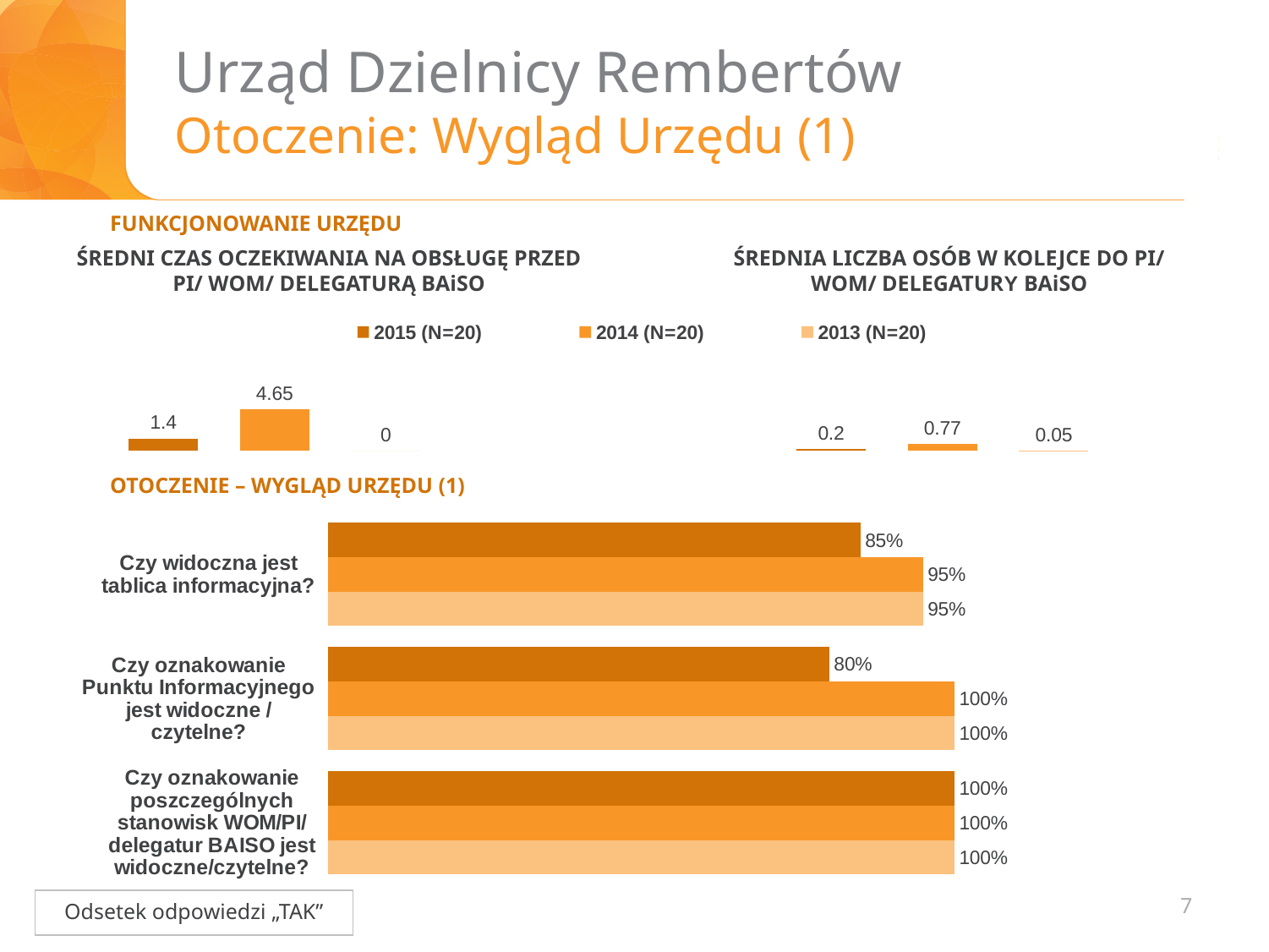
In the chart 'ŚREDNIA LICZBA OSÓB W KOLEJCE DO PI/ WOM/ DELEGATURY BAiSO', what is the value for 2015 (N=20)? 0.2 In the chart 'ŚREDNIA LICZBA OSÓB W KOLEJCE DO PI/ WOM/ DELEGATURY BAiSO', which year has the lowest value? 2013 (N=20) How many question categories are shown in the bottom chart 'OTOCZENIE – WYGLĄD URZĘDU (1)'? 3 In the bottom chart 'OTOCZENIE – WYGLĄD URZĘDU (1)', what is the difference between the 2014 and 2015 values for 'Czy oznakowanie Punktu Informacyjnego jest widoczne / czytelne?'? 20% In the chart 'ŚREDNI CZAS OCZEKIWANIA NA OBSŁUGĘ PRZED PI/ WOM/ DELEGATURĄ BAiSO', what is the difference between the 2014 and 2015 values? 3.25 In the chart 'ŚREDNIA LICZBA OSÓB W KOLEJCE DO PI/ WOM/ DELEGATURY BAiSO', which is larger: the value for 2014 or the value for 2015? 2014 In the chart 'ŚREDNI CZAS OCZEKIWANIA NA OBSŁUGĘ PRZED PI/ WOM/ DELEGATURĄ BAiSO', which year has the highest value? 2014 (N=20) How many series does the legend above the top charts list? 3 In the bottom chart 'OTOCZENIE – WYGLĄD URZĘDU (1)', what is the 2014 value for 'Czy oznakowanie Punktu Informacyjnego jest widoczne / czytelne?'? 100% In the bottom chart 'OTOCZENIE – WYGLĄD URZĘDU (1)', what is the 2015 value for 'Czy widoczna jest tablica informacyjna?'? 85% In the chart 'ŚREDNI CZAS OCZEKIWANIA NA OBSŁUGĘ PRZED PI/ WOM/ DELEGATURĄ BAiSO', what is the value for 2014 (N=20)? 4.65 What type of chart is the bottom chart 'OTOCZENIE – WYGLĄD URZĘDU (1)'? Bar chart